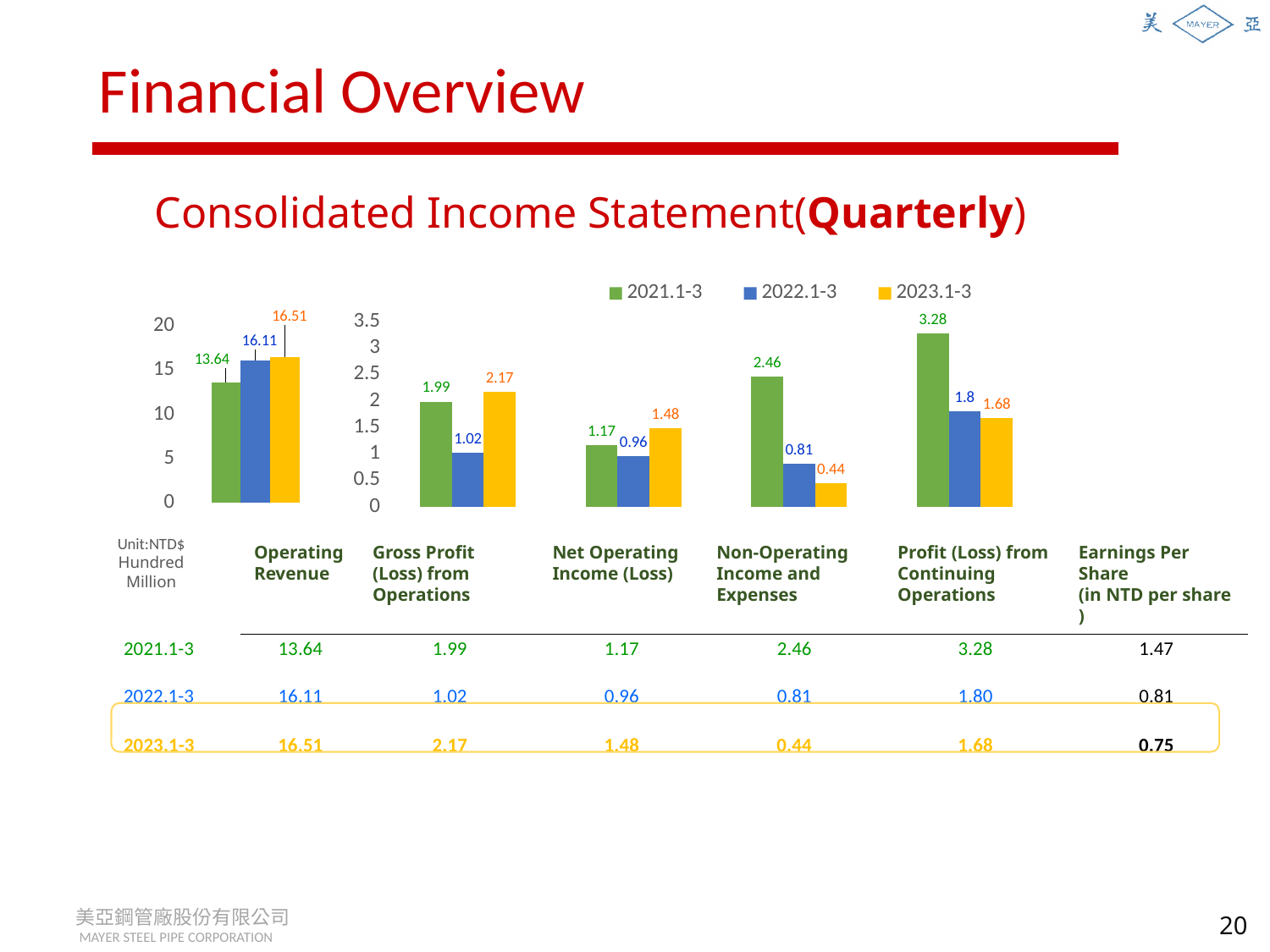
In the left chart (Operating Revenue), what is the value for 2023.1-3? 16.51 In the right chart, what is the difference between the 2021.1-3 and 2022.1-3 values for Profit (Loss) from Continuing Operations? 1.48 In the right chart, do the values for Non-Operating Income and Expenses rise or fall from 2021.1-3 to 2023.1-3? Fall In the right chart, what is the 2022.1-3 value for Gross Profit (Loss) from Operations? 1.02 In the right chart, which category has the highest 2021.1-3 value? Profit (Loss) from Continuing Operations In the left chart (Operating Revenue), which period has the lowest value? 2021.1-3 In the right chart, what is the 2023.1-3 value for Non-Operating Income and Expenses? 0.44 In the left chart (Operating Revenue), what is the difference between the 2023.1-3 and 2021.1-3 values? 2.87 In the right chart, which is larger for Net Operating Income (Loss): the 2021.1-3 value or the 2023.1-3 value? 2023.1-3 In the left chart (Operating Revenue), what is the value for 2021.1-3? 13.64 How many series does the legend list? 3 What kind of chart is used on this slide? Bar chart